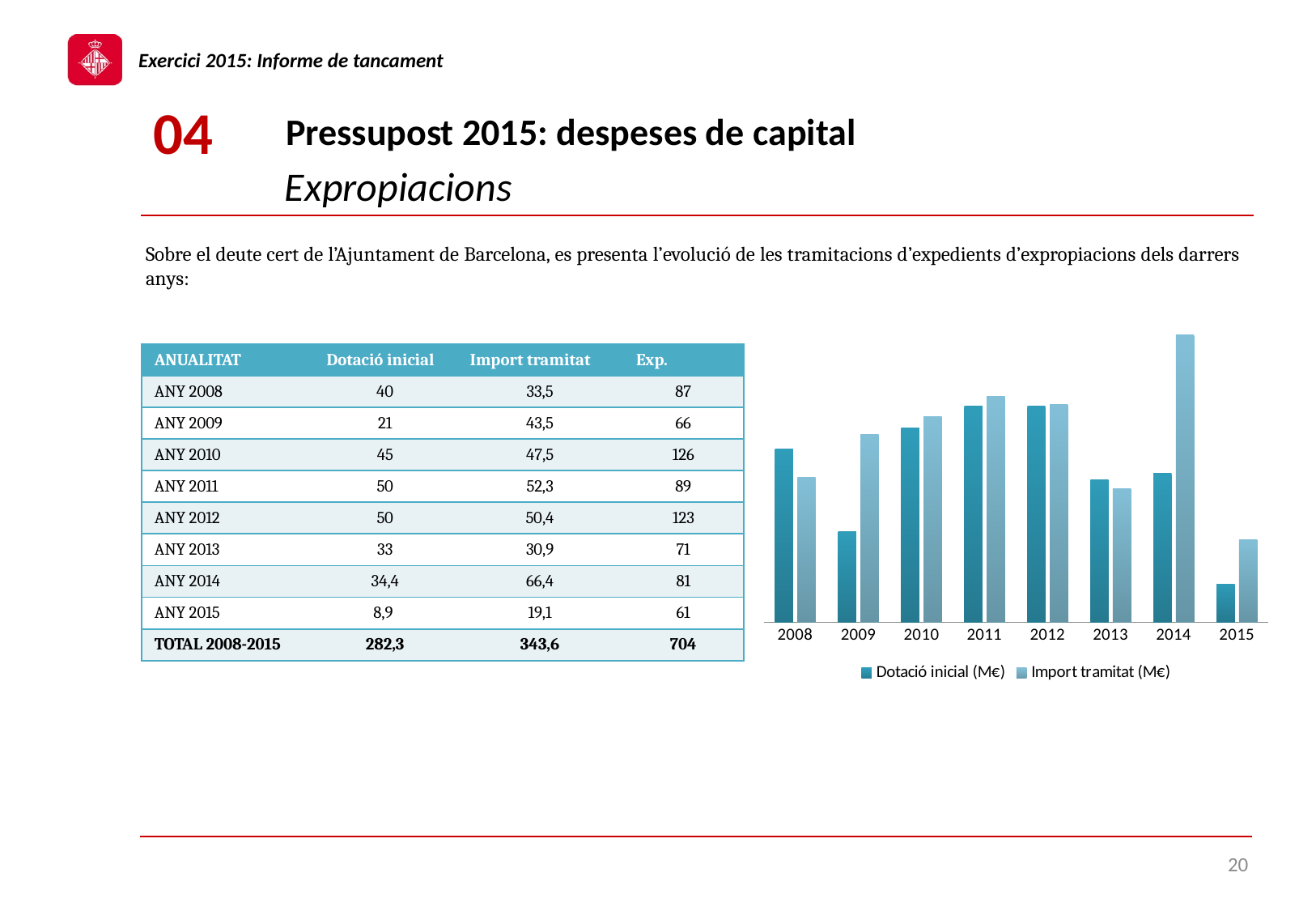
What kind of chart is shown on the slide? bar chart Does the Dotació inicial series rise or fall from 2012 to 2015 in the chart? fall What are the two legend entries of the chart? Dotació inicial (M€) and Import tramitat (M€) What is the Import tramitat value for 2014 plotted in the chart, as given in the table on the slide? 66,4 What is the Dotació inicial value for 2015 plotted in the chart, as given in the table on the slide? 8,9 Which year has the lowest Dotació inicial bar in the chart? 2015 Which year has the highest Import tramitat bar in the chart? 2014 How many series does the chart legend list? 2 In 2008, which is larger in the chart: Dotació inicial or Import tramitat? Dotació inicial How many years are shown on the x axis of the chart? 8 In 2014, which is larger in the chart: Dotació inicial or Import tramitat? Import tramitat Which year has the lowest Import tramitat bar in the chart? 2015